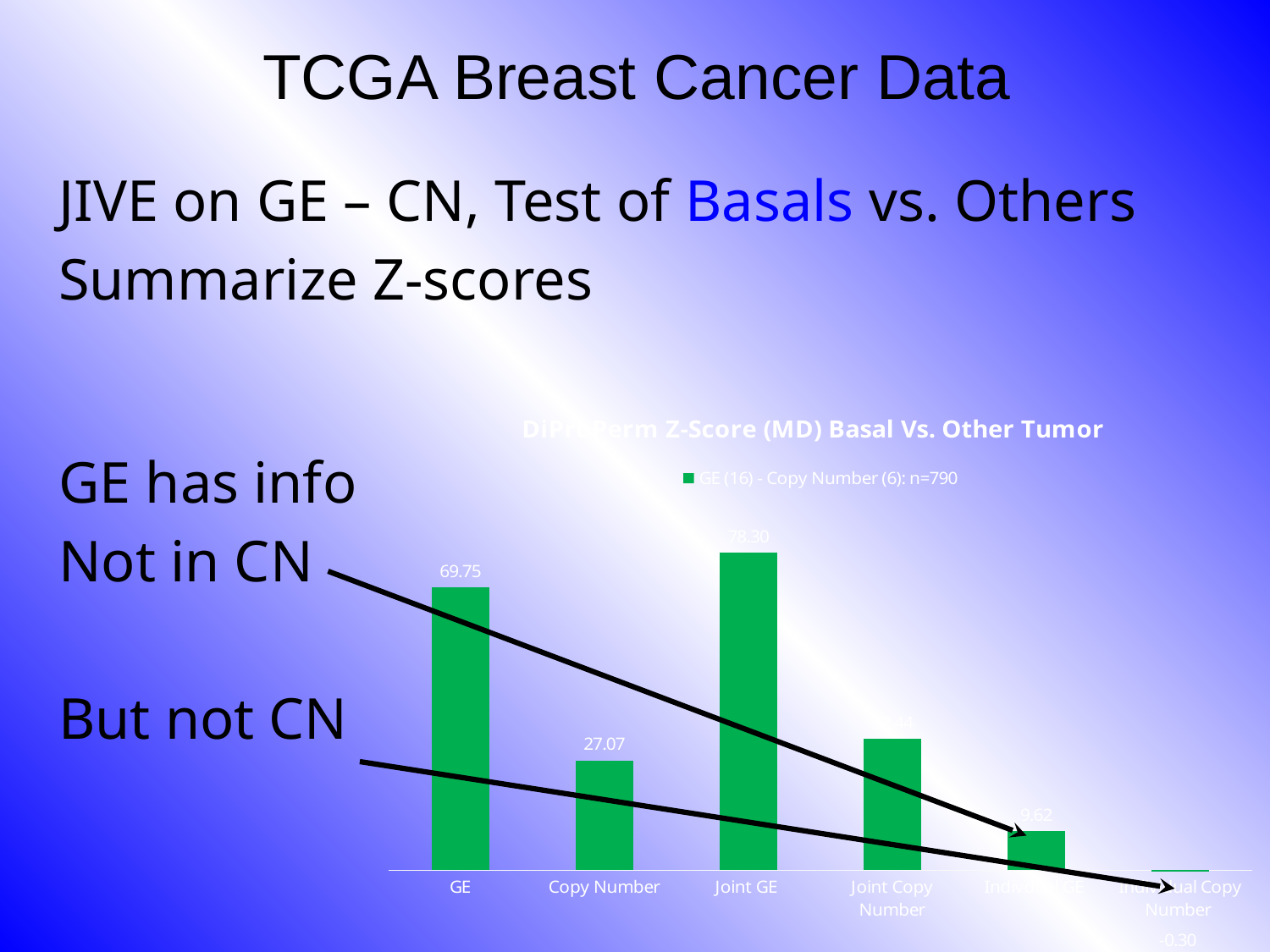
Which category has the lowest bar? Individual Copy Number What is the legend entry for the series shown in the chart? GE (16) - Copy Number (6): n=790 What is the value of the bar for Joint GE? 78.30 What kind of chart is shown on the slide? Bar chart What is the value of the bar for Individual GE? 9.62 Which is larger, the value for GE or the value for Joint GE? Joint GE How many categories are shown on the x axis? 6 Which category has the highest bar? Joint GE What is the value of the bar for Individual Copy Number? -0.30 What is the value of the bar for Copy Number? 27.07 What is the value of the bar for GE? 69.75 What is the difference between the values for GE and Copy Number? 42.68